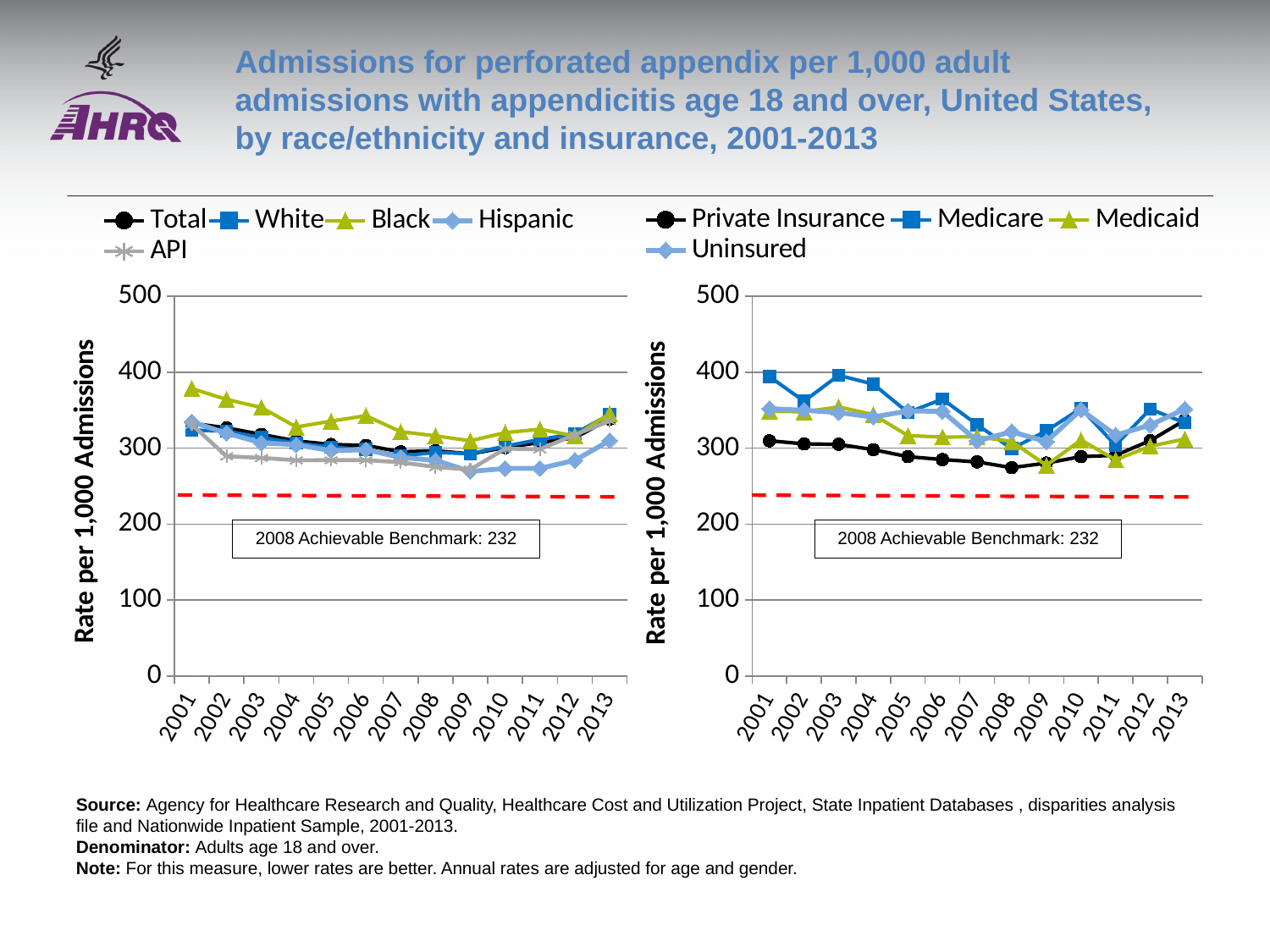
In the left chart (by race/ethnicity), is the value for Hispanic in 2009 greater or less than 300? less In the right chart (by insurance), is the value for Medicare in 2001 greater or less than 300? greater In the left chart (by race/ethnicity), which group had the highest rate in 2001? Black In the right chart (by insurance), is the value for Private Insurance in 2008 greater or less than 300? less What type of chart is the left chart (by race/ethnicity)? Line chart In the right chart (by insurance), did the Private Insurance rate rise or fall from 2001 to 2009? Fall How many series does the legend of the left chart (by race/ethnicity) list? 5 In the right chart (by insurance), which group had the lowest rate in 2001? Private Insurance What is the 2008 Achievable Benchmark value shown on the charts? 232 How many years are shown on the x axis of the right chart (by insurance)? 13 How many series does the legend of the right chart (by insurance) list? 4